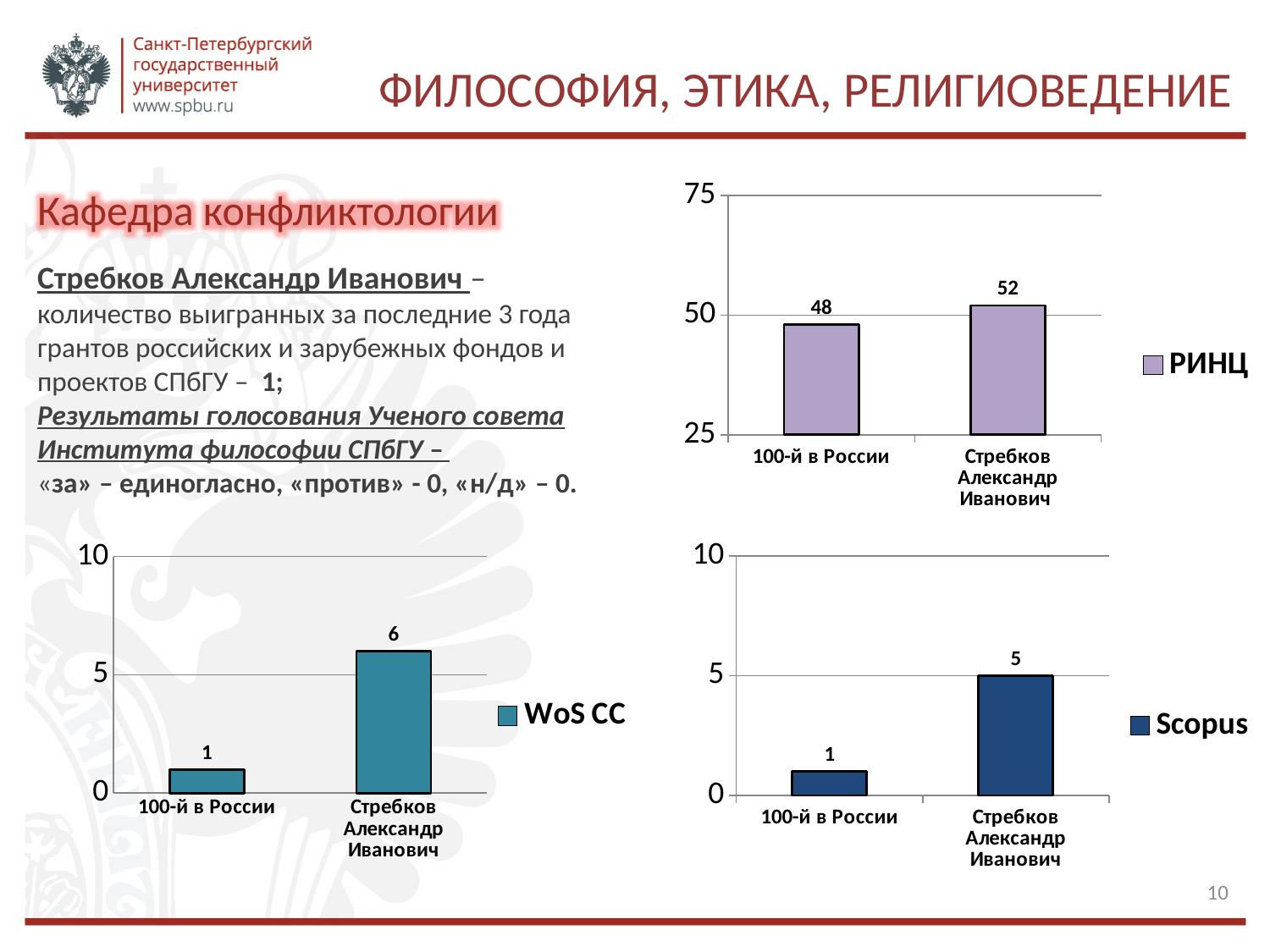
In the WoS CC chart (bottom left), what is the value for Стребков Александр Иванович? 6 In the Scopus chart (bottom right), what is the difference between the value for Стребков Александр Иванович and the value for 100-й в России? 4 In the РИНЦ chart (top right), what is the difference between the value for Стребков Александр Иванович and the value for 100-й в России? 4 In the РИНЦ chart (top right), what is the value for Стребков Александр Иванович? 52 How many categories are shown in the Scopus chart (bottom right)? 2 In the Scopus chart (bottom right), which category has the lowest value? 100-й в России What kind of chart is the WoS CC chart (bottom left)? bar chart In the WoS CC chart (bottom left), which category has the highest value? Стребков Александр Иванович In the WoS CC chart (bottom left), what is the value for 100-й в России? 1 In the РИНЦ chart (top right), is the value for 100-й в России greater or less than 50? less In the РИНЦ chart (top right), what is the value for 100-й в России? 48 In the Scopus chart (bottom right), what is the value for Стребков Александр Иванович? 5